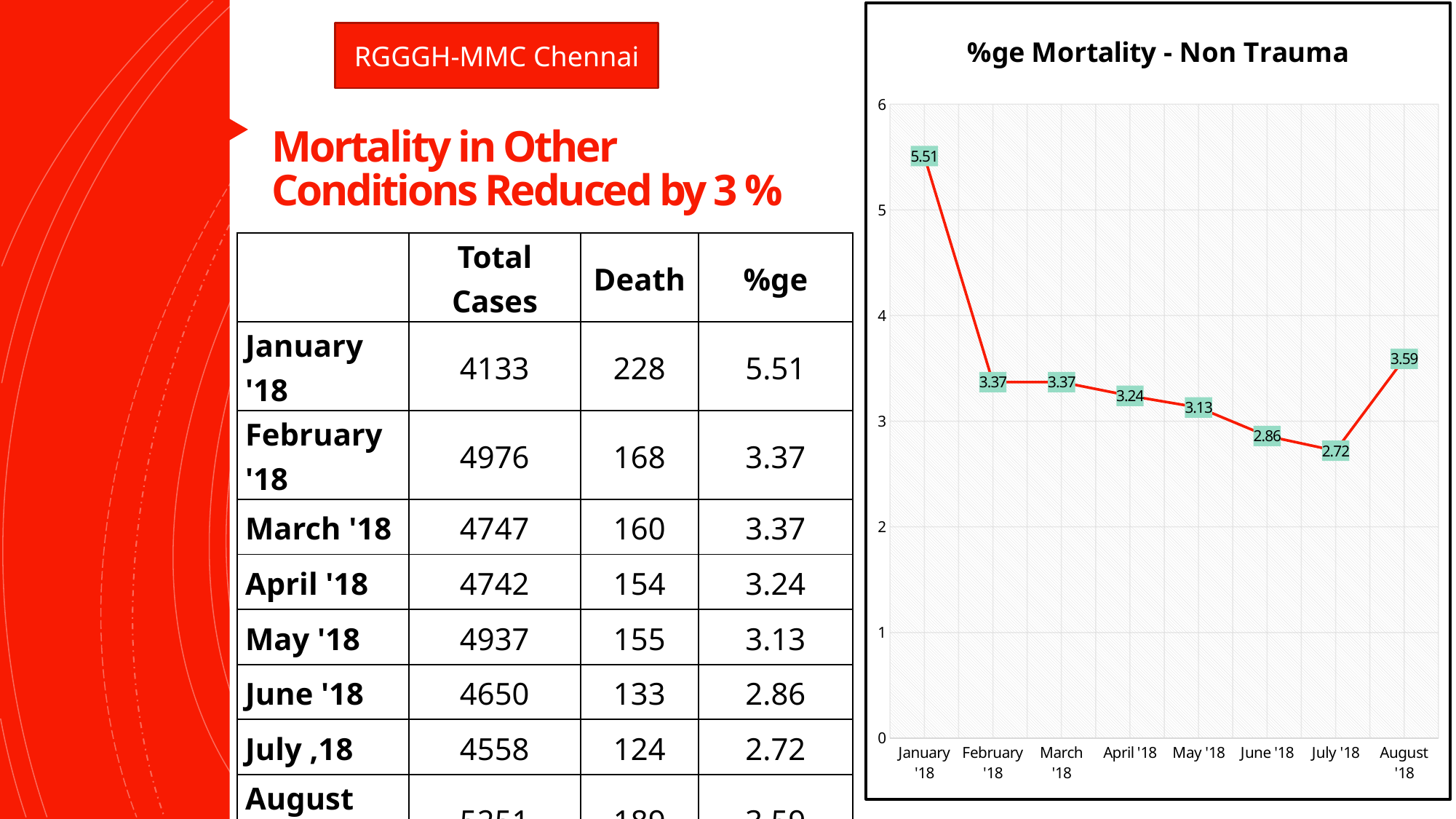
What is the %ge mortality for August '18 in the chart? 3.59 What is the %ge mortality for January '18 in the chart? 5.51 Which month has the highest %ge mortality in the chart? January '18 Does the %ge mortality rise or fall from January '18 to July '18? fall Which has a higher %ge mortality, June '18 or August '18? August '18 Is the %ge mortality for May '18 greater or less than 4? less How many months are plotted in the chart? 8 What kind of chart is shown on the slide? line chart What is the title of the chart? %ge Mortality - Non Trauma What is the %ge mortality for July '18 in the chart? 2.72 Which month has the lowest %ge mortality in the chart? July '18 What is the difference in %ge mortality between January '18 and February '18? 2.14